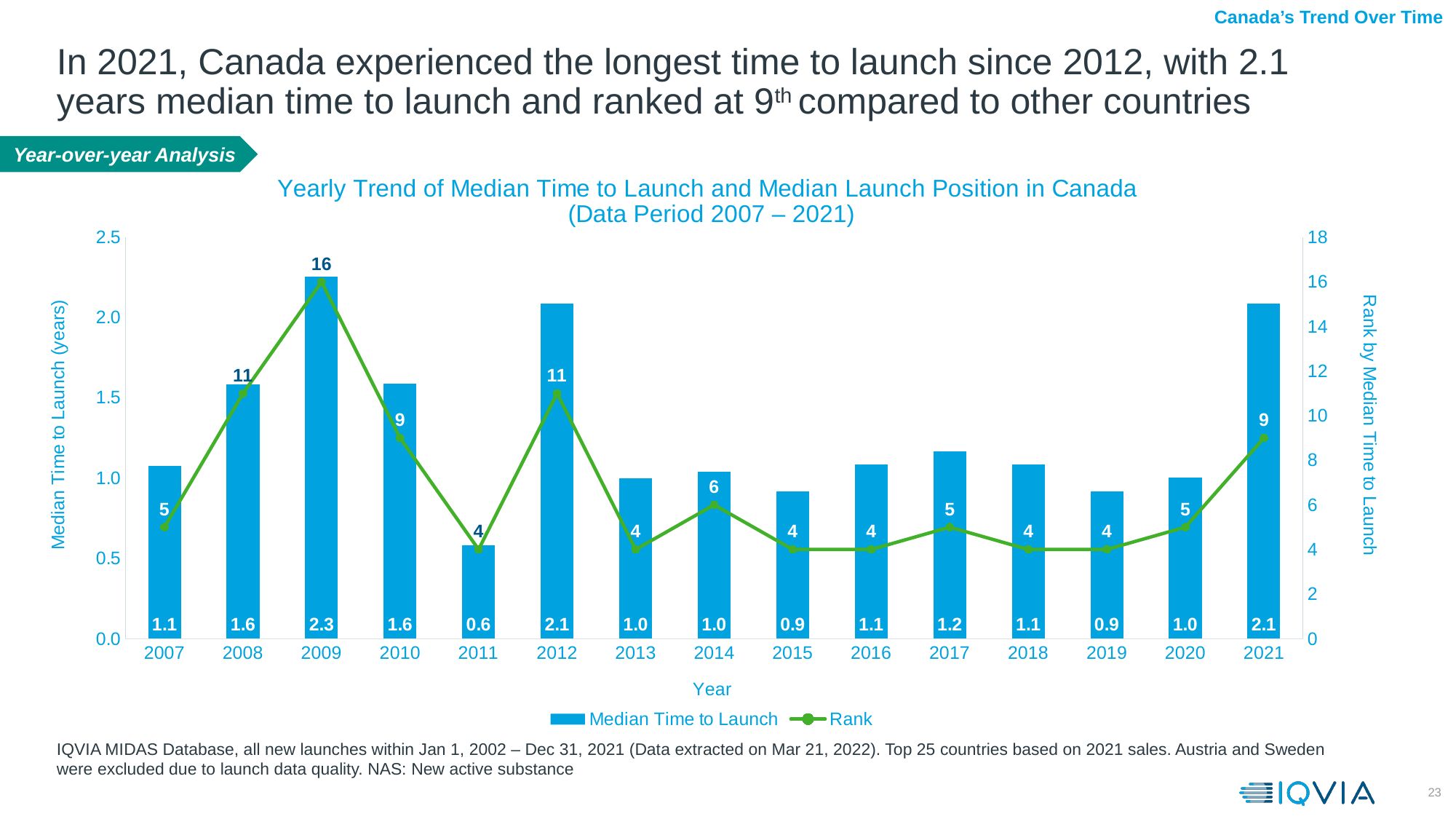
Which year has the highest median time to launch? 2009 What is the median time to launch in Canada for 2009? 2.3 Which year has the lowest median time to launch? 2011 What is the title of the chart? Yearly Trend of Median Time to Launch and Median Launch Position in Canada (Data Period 2007 – 2021) What is the difference between the median time to launch in 2021 and in 2020? 1.1 What is Canada's rank by median time to launch in 2021? 9 Which year has a higher rank value, 2008 or 2010? 2008 What is the label of the right-hand y axis? Rank by Median Time to Launch How many series does the legend list? 2 What kind of chart is used to show the Median Time to Launch series? Bar chart What is the difference between the rank in 2009 and the rank in 2012? 5 How many years are shown on the x axis? 15